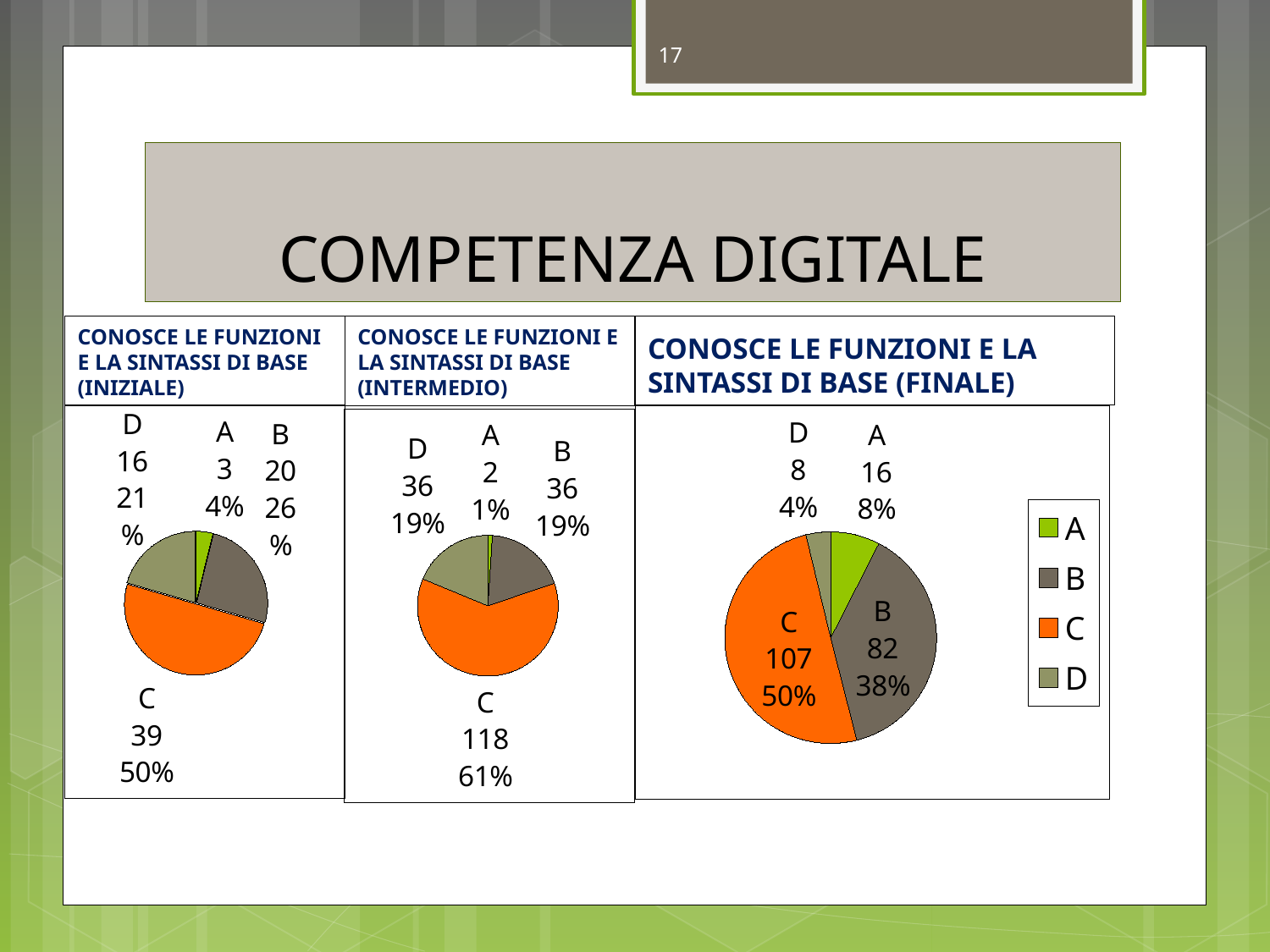
In the INIZIALE pie chart, what percentage share does category B have? 26% In the INIZIALE pie chart, what is the value for category C? 39 How many categories does the legend on the right of the slide list? 4 In the legend on the right of the slide, which colour represents category C? Orange In the INTERMEDIO pie chart, which category has the lowest value? A In the INTERMEDIO pie chart, what percentage share does category D have? 19% In the FINALE pie chart, what is the value for category B? 82 In the FINALE pie chart, which is larger, the value for A or the value for D? A What type of chart is used for the INIZIALE, INTERMEDIO and FINALE data? Pie chart In the INTERMEDIO pie chart, what is the value for category C? 118 In the FINALE pie chart, what is the difference between the values for C and B? 25 In the FINALE pie chart, which category has the highest value? C